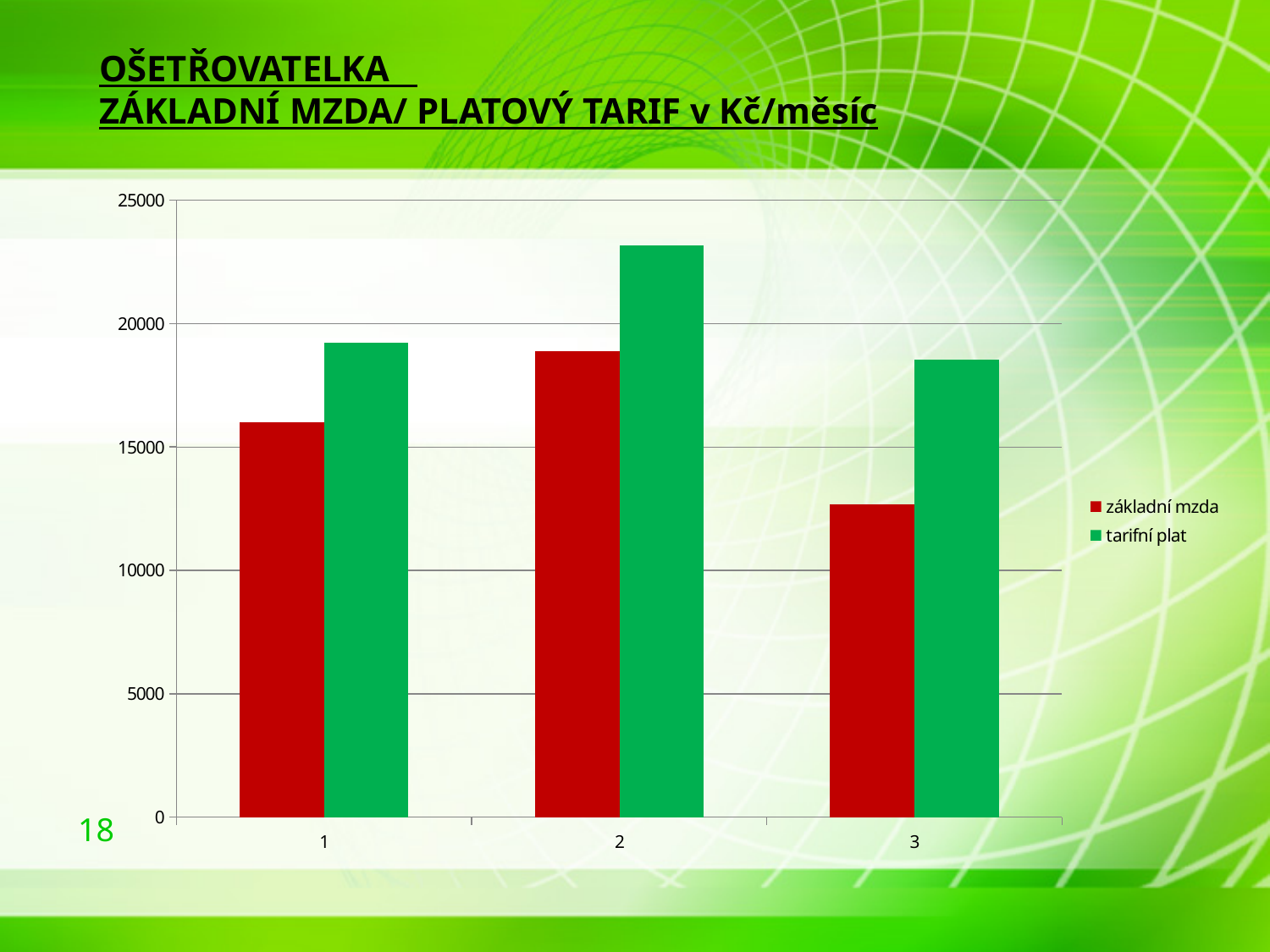
Is the value for tarifní plat in category 3 greater or less than 20000? less Is the value for základní mzda in category 3 greater or less than 15000? less Which colour represents základní mzda in the legend? red Is the value for základní mzda in category 1 greater or less than 15000? greater In category 3, which is larger: základní mzda or tarifní plat? tarifní plat What kind of chart is shown on the slide? bar chart Which category has the highest value for tarifní plat? 2 How many series does the legend list? 2 In category 1, which is larger: základní mzda or tarifní plat? tarifní plat Which category has the lowest value for základní mzda? 3 How many categories are shown on the x axis? 3